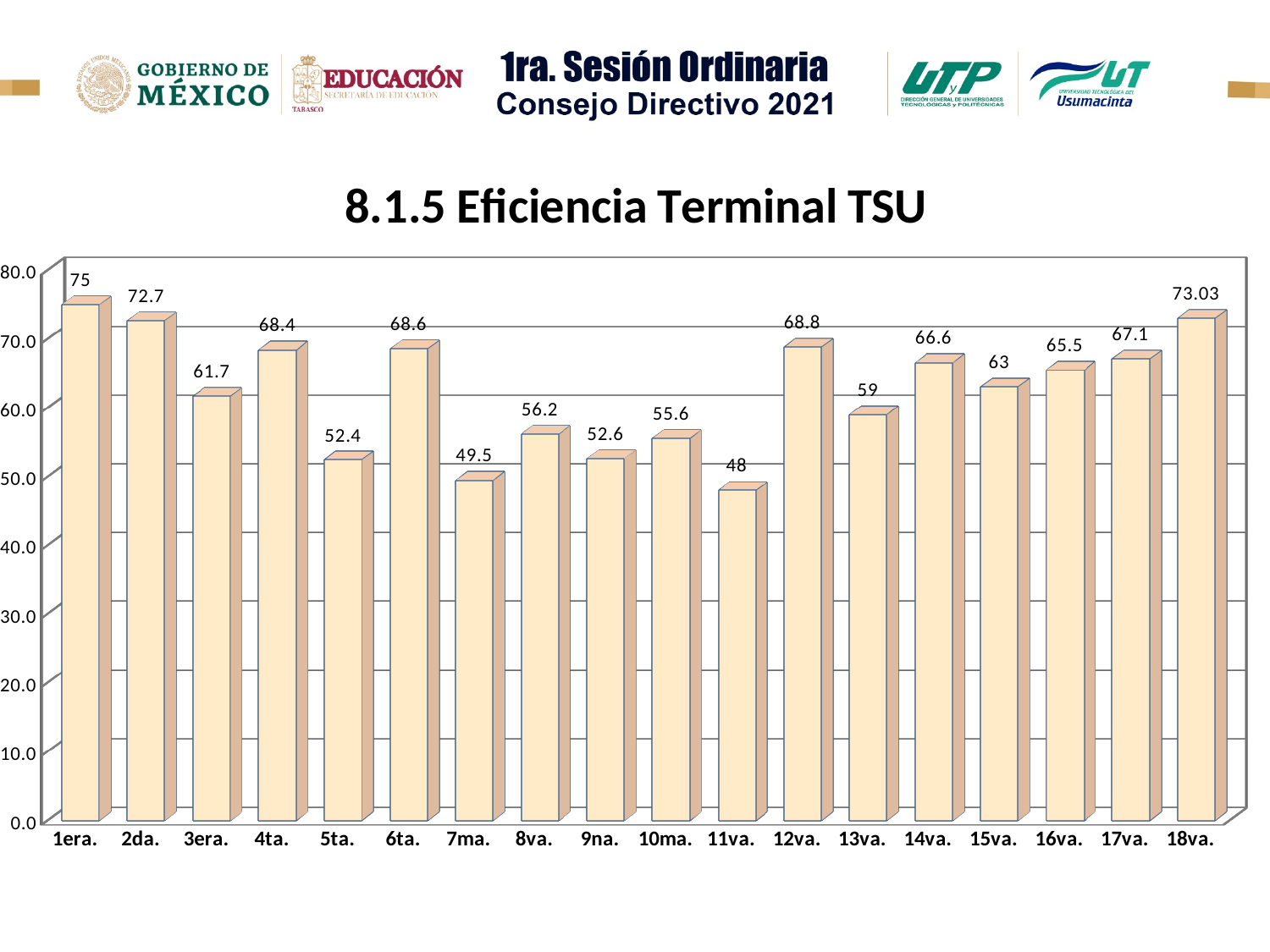
Which category has the highest value? 1era. What is the value for the 11va. generation? 48 Do the values rise or fall from 13va. to 18va.? rise What kind of chart is shown? bar chart What is the value for the 1era. generation? 75 What is the title of the chart? 8.1.5 Eficiencia Terminal TSU Is the value for 13va. greater or less than 60.0? less How many categories are shown on the x axis? 18 What is the difference between the values for 1era. and 11va.? 27 Which category has the lowest value? 11va. Which is larger, the value for 4ta. or the value for 6ta.? 6ta. What is the value for the 18va. generation? 73.03